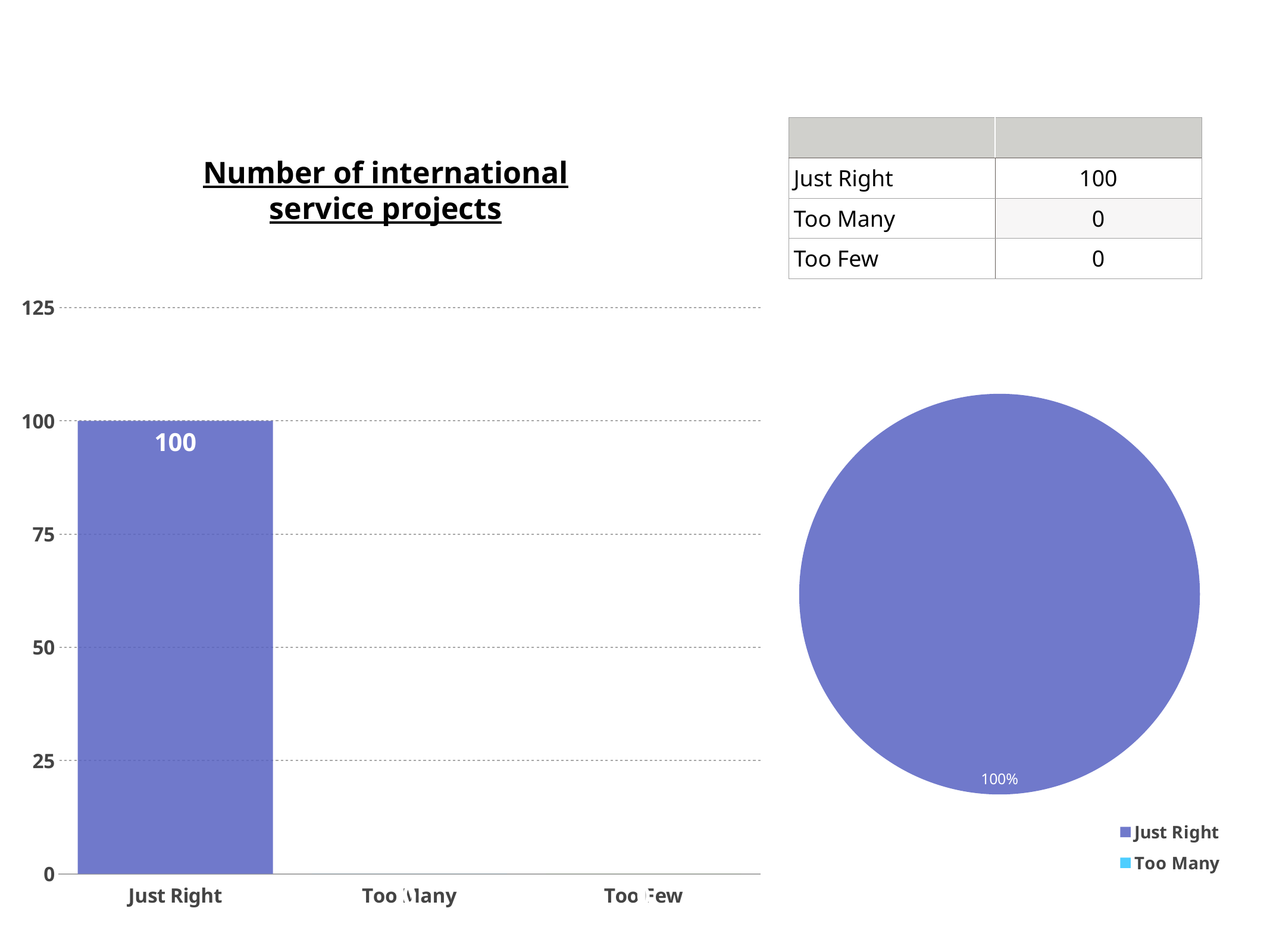
In the pie chart on the right side of the slide, which category does the legend list after Just Right? Too Many In the bar chart titled 'Number of international service projects', is the value for Just Right greater or less than 75? greater What kind of chart is the chart on the right side of the slide? pie chart In the bar chart titled 'Number of international service projects', what is the highest value shown on the vertical axis? 125 In the bar chart titled 'Number of international service projects', how many categories are shown on the x axis? 3 What kind of chart is the chart titled 'Number of international service projects'? bar chart In the bar chart titled 'Number of international service projects', which is larger, the value for Just Right or the value for Too Many? Just Right In the bar chart titled 'Number of international service projects', what is the value for Just Right? 100 In the bar chart titled 'Number of international service projects', what is the difference between the value for Just Right and the value for Too Few? 100 In the bar chart titled 'Number of international service projects', which category has the highest value? Just Right How many entries does the legend of the pie chart on the right side of the slide list? 2 In the pie chart on the right side of the slide, what share does the Just Right slice have? 100%